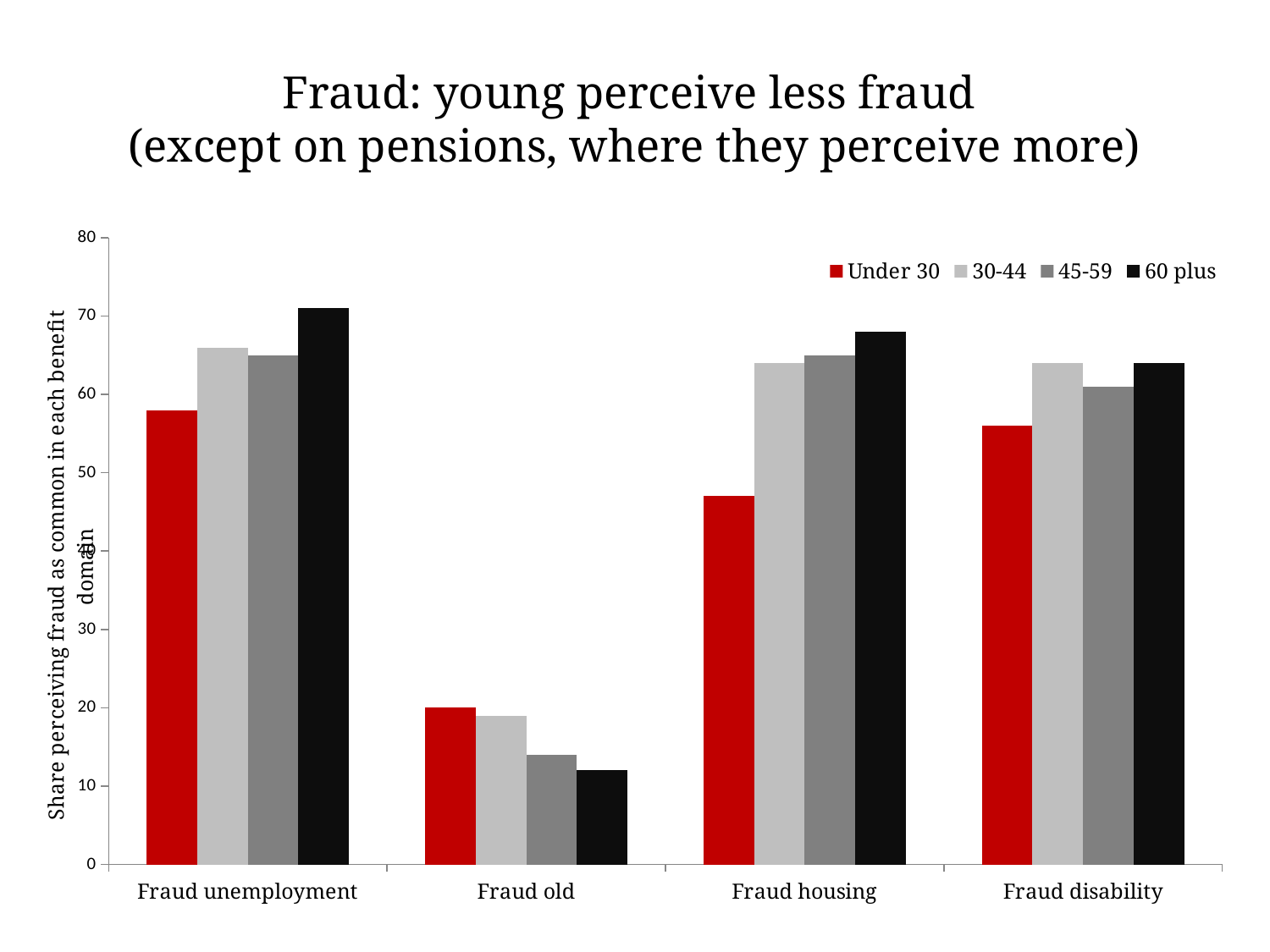
Is the value for Under 30 in Fraud unemployment greater or less than 50? greater Is the value for Under 30 in Fraud housing greater or less than 50? less How many benefit categories are shown on the x axis? 4 What kind of chart is shown on the slide? Bar chart Within the Fraud unemployment category, which age group has the highest bar? 60 plus Within the Fraud housing category, which age group has the lowest bar? Under 30 Is the value for 60 plus in Fraud old greater or less than 20? less How many series does the legend list? 4 For the Under 30 group, which is larger: Fraud unemployment or Fraud housing? Fraud unemployment Which category has the lowest values across all age groups? Fraud old In the Fraud old category, which is larger: the Under 30 bar or the 60 plus bar? Under 30 Which colour represents the Under 30 series in the legend? Red